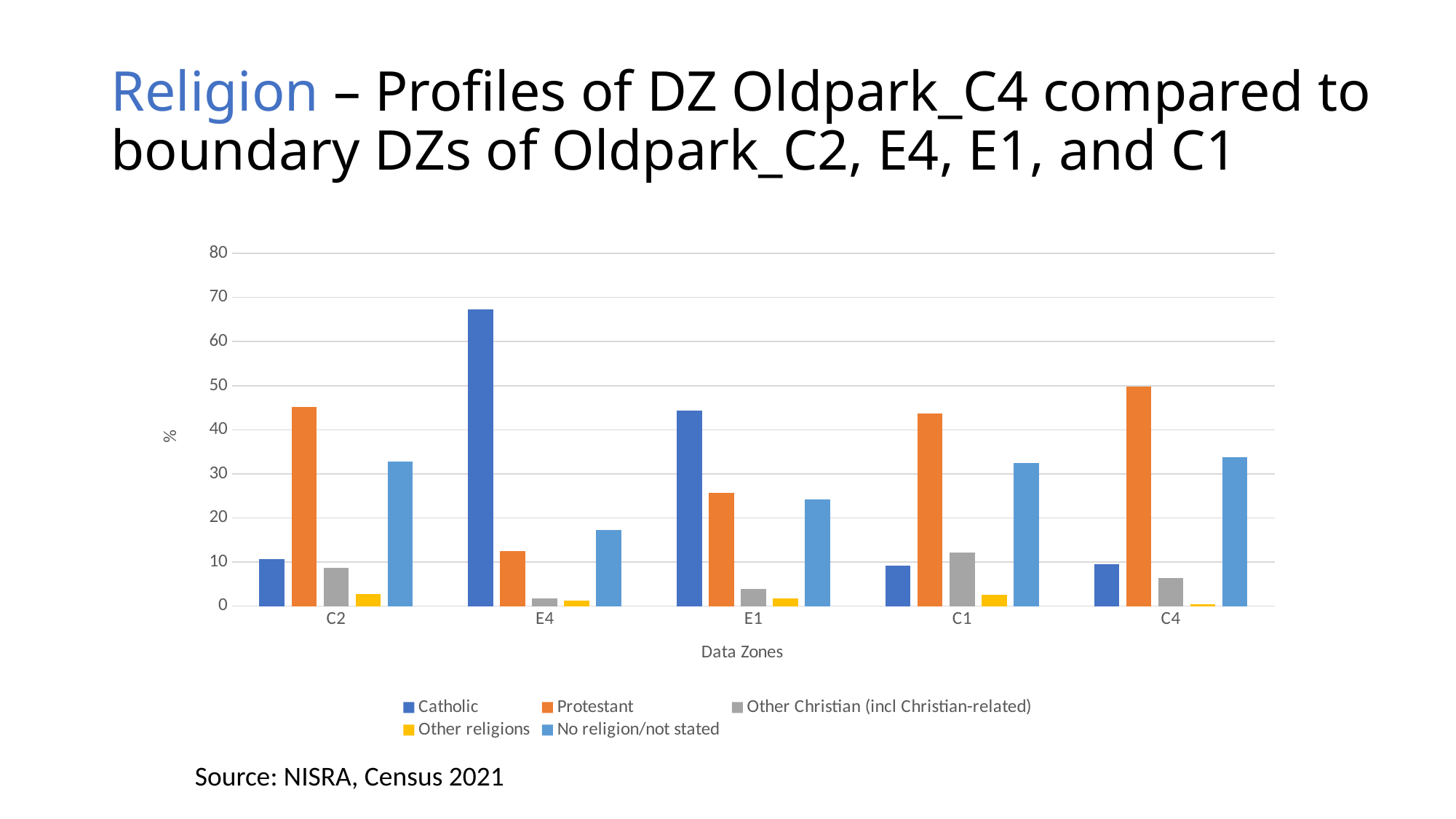
Which data zone has the lowest Other religions percentage? C4 In E1, which is larger: the Catholic value or the Protestant value? Catholic How many series does the legend list? 5 Which data zone has the highest Protestant percentage? C4 What kind of chart is shown on the slide? Bar chart Is the Protestant value for C2 greater or less than 40? greater Is the No religion/not stated value for E4 greater or less than 20? less Which data zone has the highest Catholic percentage? E4 How many data zones are shown on the x axis? 5 Which is larger: the Other Christian (incl Christian-related) value for C1 or for C2? C1 Is the Catholic value for E4 greater or less than 60? greater What is the title of the x axis? Data Zones